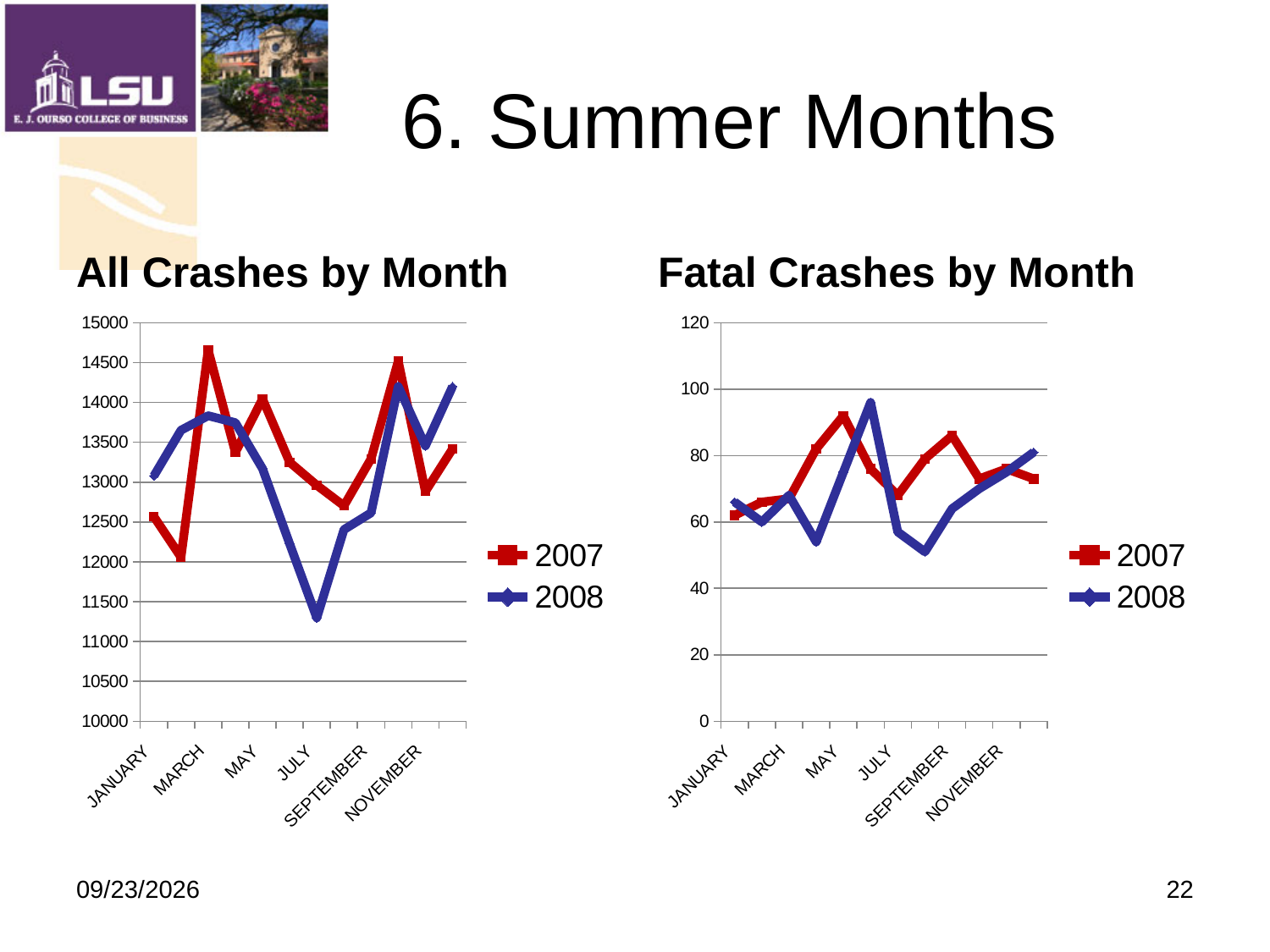
How many series does the legend of the 'Fatal Crashes by Month' chart list? 2 In the 'All Crashes by Month' chart, which series has the larger value in JULY, 2007 or 2008? 2007 What are the two series listed in the legend of the 'All Crashes by Month' chart? 2007 and 2008 In the 'Fatal Crashes by Month' chart, which series has the larger value in JULY, 2007 or 2008? 2007 In the 'All Crashes by Month' chart, is the 2008 value for JULY greater or less than 12000? less What kind of chart is the 'All Crashes by Month' chart? line chart In the 'Fatal Crashes by Month' chart, which month has the highest value for 2008? JUNE In the 'All Crashes by Month' chart, is the 2007 value for MARCH greater or less than 14500? greater In the 'Fatal Crashes by Month' chart, which month has the highest value for 2007? MAY In the 'Fatal Crashes by Month' chart, is the 2007 value for MAY greater or less than 80? greater In the 'All Crashes by Month' chart, which month has the lowest value for 2008? JULY